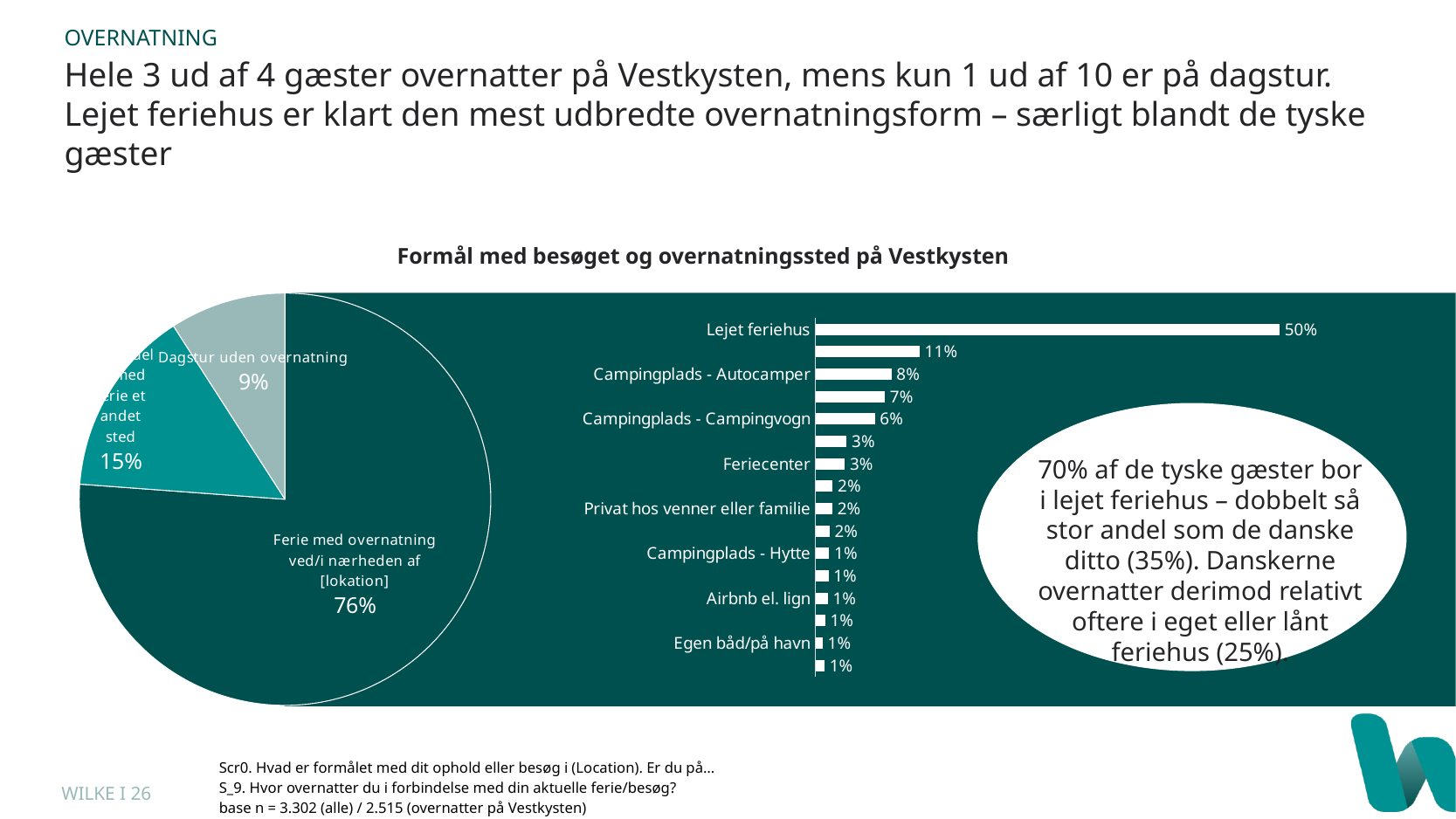
In the bar chart on the right, what is the value for "Campingplads - Autocamper"? 8% In the bar chart on the right, which category has the highest value? Lejet feriehus What is the title shown above the charts on the slide? Formål med besøget og overnatningssted på Vestkysten In the bar chart on the right, what is the value for "Lejet feriehus"? 50% In the bar chart on the right, what is the difference between the values for "Lejet feriehus" and "Campingplads - Autocamper"? 42% In the bar chart on the right, what is the value for "Campingplads - Campingvogn"? 6% In the bar chart on the right, what is the value for "Feriecenter"? 3% In the pie chart on the left, what share is shown for "Ferie med overnatning ved/i nærheden af [lokation]"? 76% In the pie chart on the left, which slice is the largest? Ferie med overnatning ved/i nærheden af [lokation] What kind of chart is the chart on the right of the slide? Bar chart In the pie chart on the left, what share is shown for "Dagstur uden overnatning"? 9% In the bar chart on the right, which is larger: "Campingplads - Autocamper" or "Campingplads - Campingvogn"? Campingplads - Autocamper